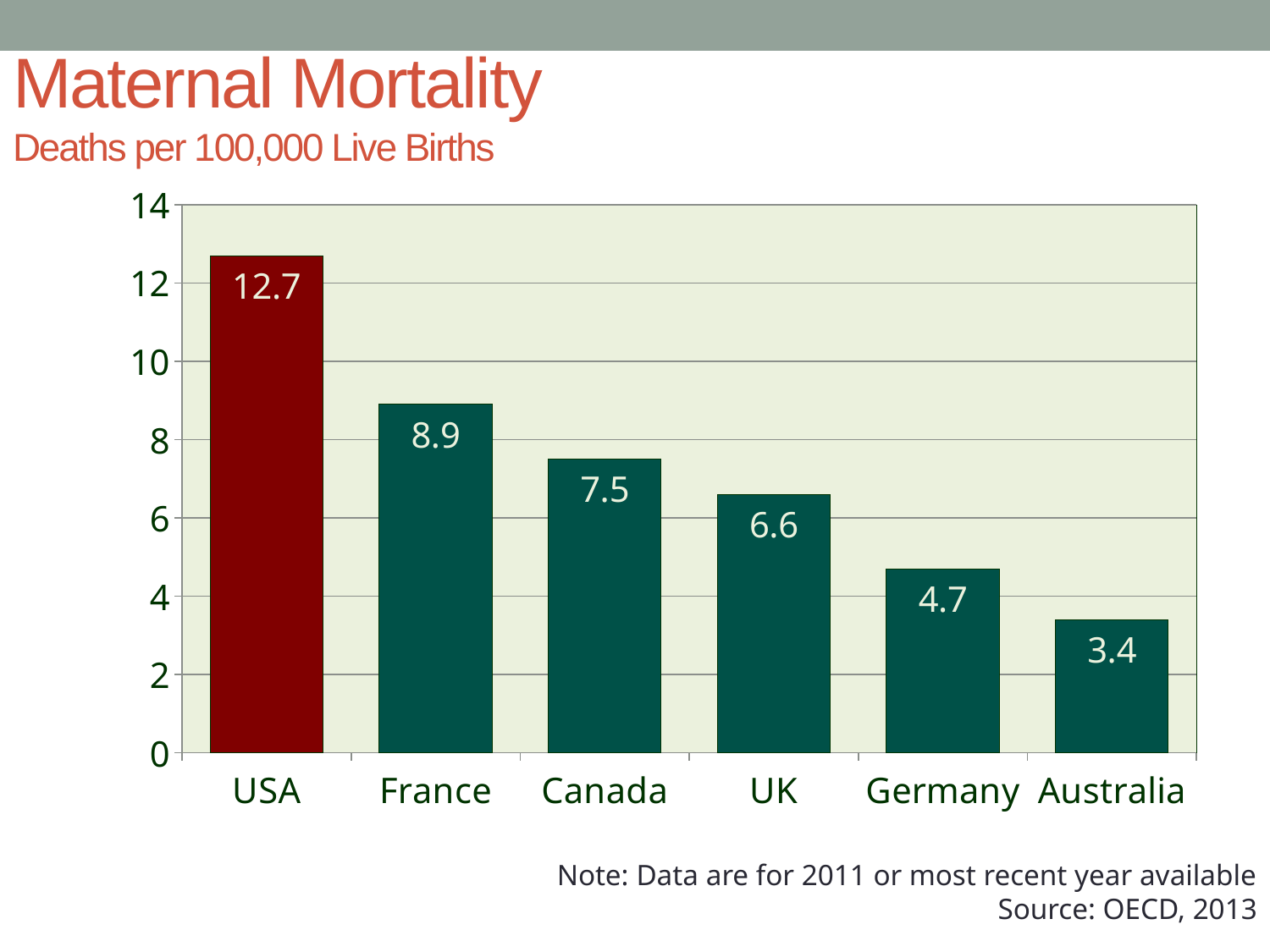
Which country has the highest maternal mortality rate on the chart? USA Which has a higher value, France or Canada? France How many countries are shown on the chart? 6 Which bar is coloured differently from the others? USA What is the value shown for Canada? 7.5 Which country has the lowest maternal mortality rate on the chart? Australia What is the maternal mortality value for the USA? 12.7 Is the value for the UK greater or less than 8? less What is the difference between the values for the UK and Australia? 3.2 What is the difference between the values for the USA and France? 3.8 What kind of chart is shown on the slide? bar chart What is the value shown for Germany? 4.7